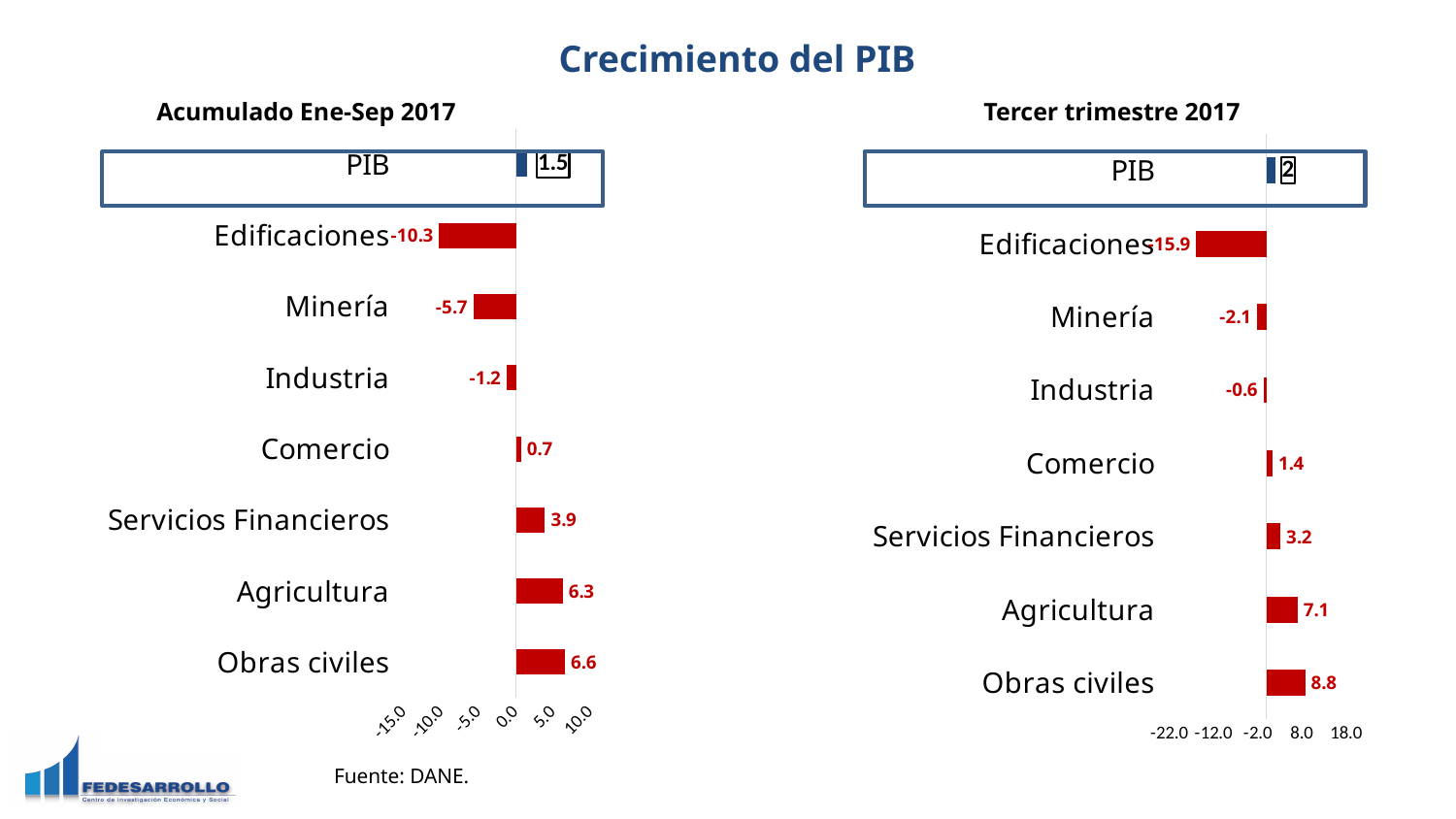
In the 'Acumulado Ene-Sep 2017' chart, what is the difference between the values for Obras civiles and Agricultura? 0.3 In the 'Acumulado Ene-Sep 2017' chart, what is the value for Obras civiles? 6.6 In the 'Acumulado Ene-Sep 2017' chart, what is the value for Minería? -5.7 In the 'Tercer trimestre 2017' chart, what is the value for PIB? 2 How many categories are shown in the 'Acumulado Ene-Sep 2017' chart? 8 In the 'Tercer trimestre 2017' chart, what is the difference between the values for Obras civiles and Servicios Financieros? 5.6 In the 'Tercer trimestre 2017' chart, what is the value for Agricultura? 7.1 In the 'Tercer trimestre 2017' chart, is the value for Edificaciones greater or less than -12.0? less In the 'Tercer trimestre 2017' chart, which category has the highest value? Obras civiles What kind of chart is the 'Tercer trimestre 2017' chart? Bar chart In the 'Acumulado Ene-Sep 2017' chart, which category has the lowest value? Edificaciones In the 'Tercer trimestre 2017' chart, which is larger, the value for Comercio or the value for Servicios Financieros? Servicios Financieros